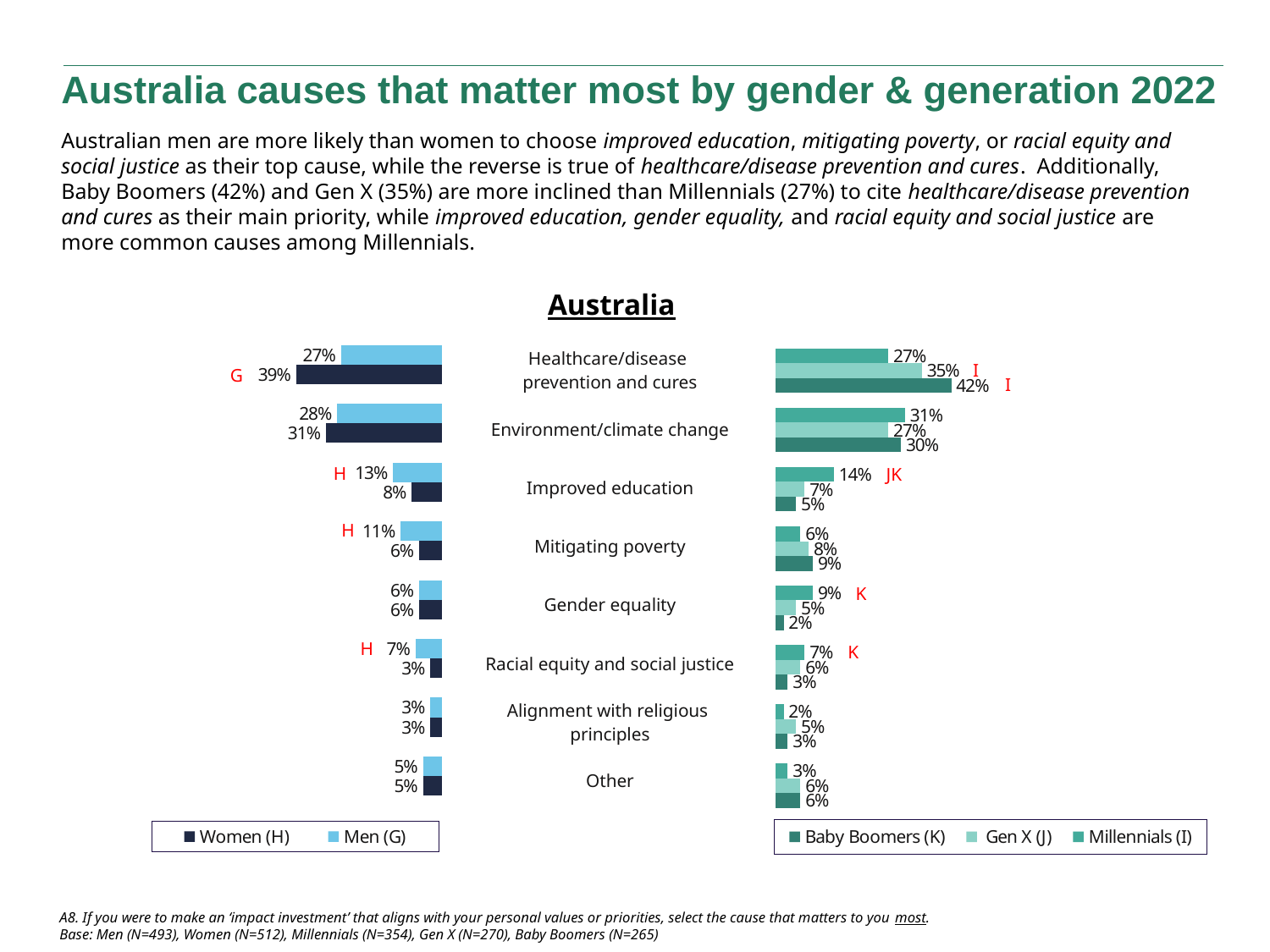
In the right chart (generation), what percentage of Baby Boomers chose healthcare/disease prevention and cures? 42% How many causes are listed in the left chart (gender)? 8 In the left chart (gender), what is the difference between women and men for healthcare/disease prevention and cures? 12 percentage points In the right chart (generation), what percentage of Millennials chose gender equality? 9% In the right chart (generation), which cause has the lowest value for Baby Boomers? Gender equality In the right chart (generation), which group has the larger value for environment/climate change, Millennials or Gen X? Millennials In the left chart (gender), what percentage of men chose improved education? 13% How many series does the legend of the right chart (generation) list? 3 In the left chart (gender), which cause has the highest value for women? Healthcare/disease prevention and cures In the right chart (generation), what is the difference between Millennials and Baby Boomers for improved education? 9 percentage points What type of chart is the left chart (gender)? Bar chart In the left chart (gender), what percentage of women chose healthcare/disease prevention and cures? 39%